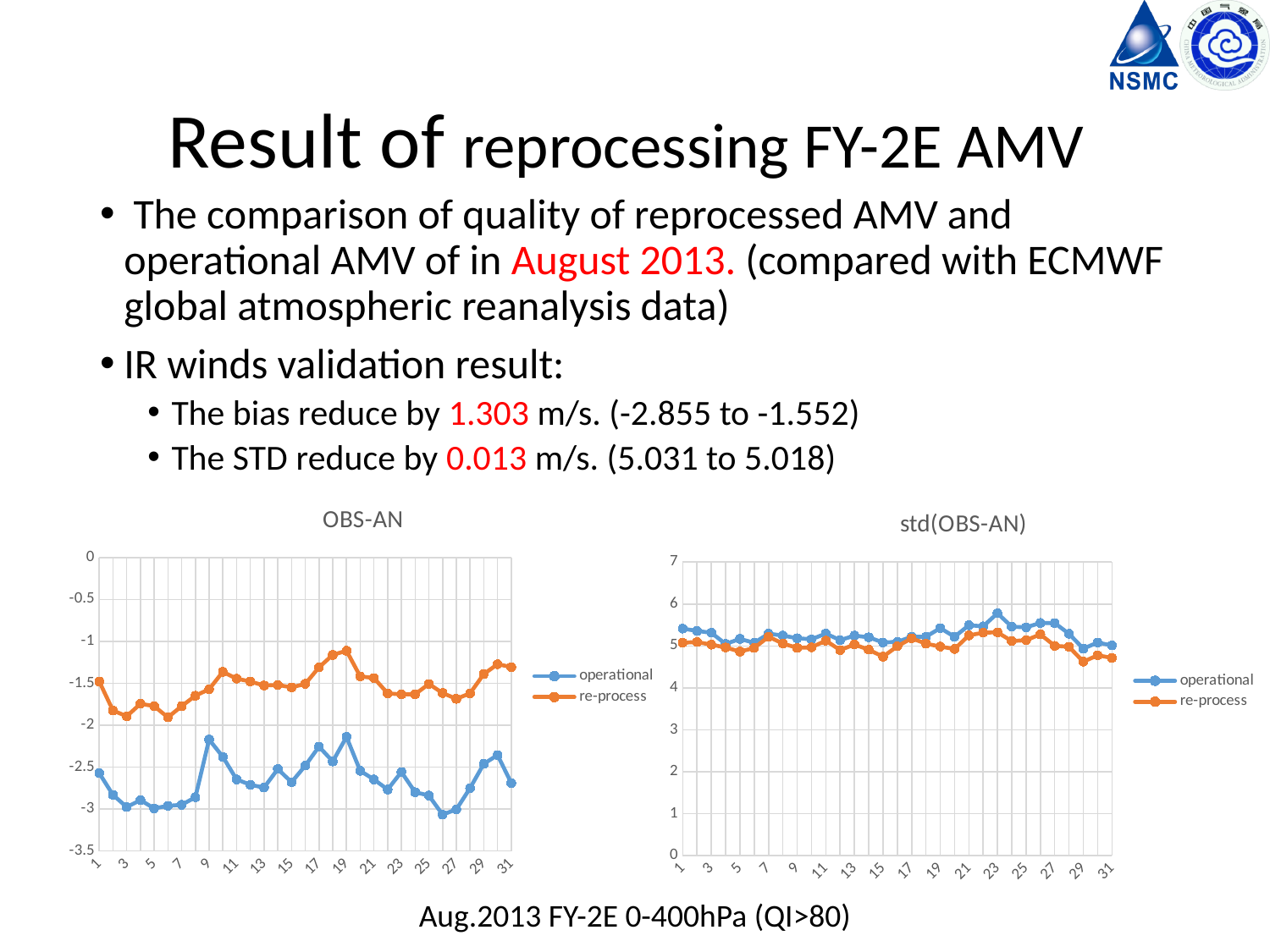
In the OBS-AN chart, is the re-process value on day 6 greater or less than -1.5? less In the OBS-AN chart, on which day does the re-process series reach its highest value? 19 In the std(OBS-AN) chart, is the re-process value on day 29 greater or less than 5? less What kind of chart is the OBS-AN chart on the left? line chart In the OBS-AN chart, is the re-process value on day 19 greater or less than -1.5? greater In the OBS-AN chart, which series has the higher value on day 9, operational or re-process? re-process What are the two series named in the legend of the std(OBS-AN) chart? operational and re-process How many series does the legend of the OBS-AN chart list? 2 What kind of chart is the std(OBS-AN) chart on the right? line chart How many points are plotted along the x axis for each series in the OBS-AN chart? 31 In the std(OBS-AN) chart, on which day does the operational series reach its highest value? 23